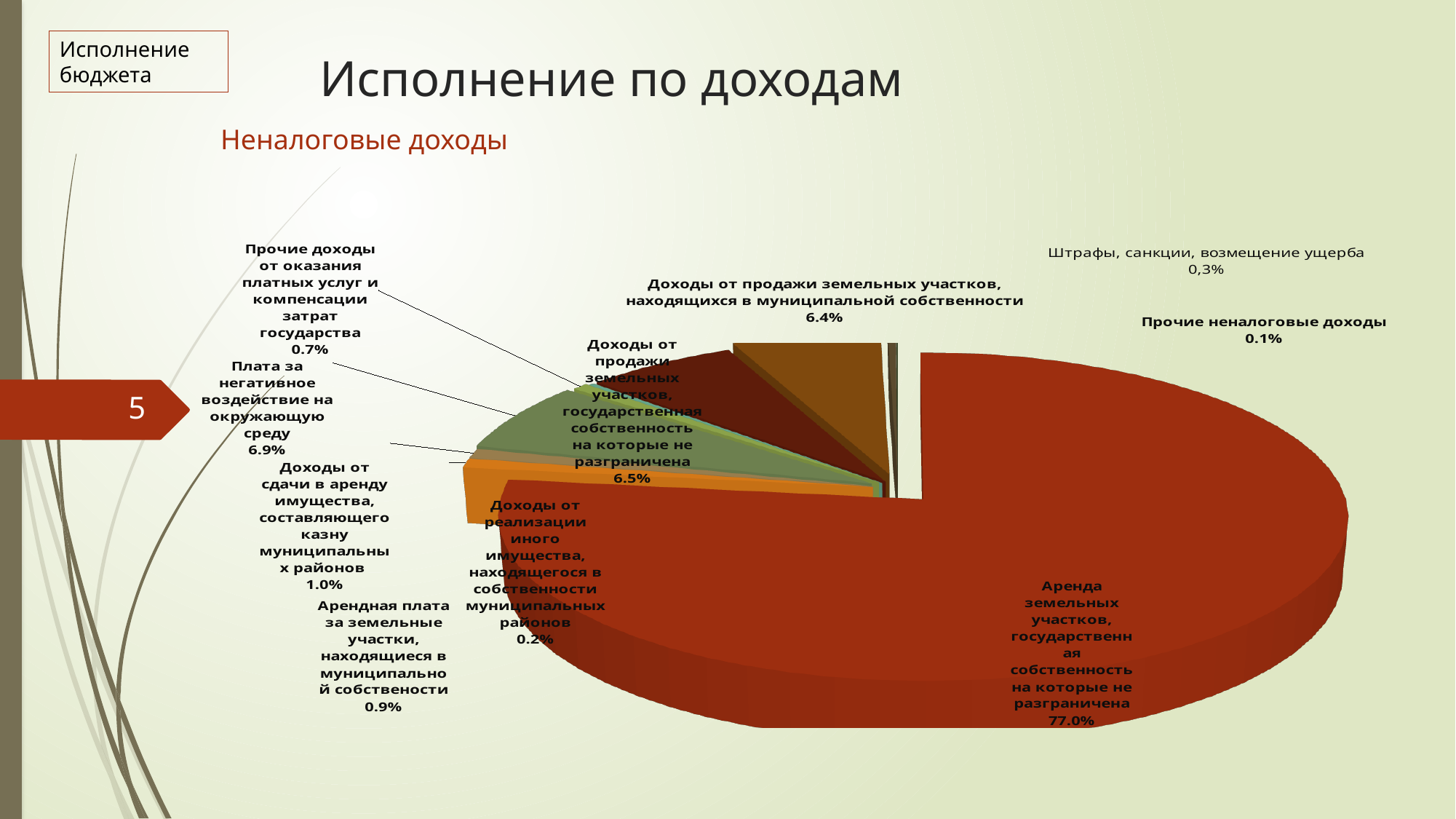
How many categories are shown in the pie chart? 10 Which category has the largest share of the pie? Аренда земельных участков, государственная собственность на которые не разграничена What is the value shown for "Плата за негативное воздействие на окружающую среду"? 6.9% Which category has the smallest share of the pie? Прочие неналоговые доходы Which is larger: the share for "Доходы от сдачи в аренду имущества, составляющего казну муниципальных районов" or for "Арендная плата за земельные участки, находящиеся в муниципальной собственности"? Доходы от сдачи в аренду имущества, составляющего казну муниципальных районов What share of non-tax revenues does "Аренда земельных участков, государственная собственность на которые не разграничена" account for? 77.0% What is the difference between the shares of "Плата за негативное воздействие на окружающую среду" and "Доходы от продажи земельных участков, государственная собственность на которые не разграничена"? 0.4% What is the subtitle of the chart shown on the slide? Неналоговые доходы What is the value shown for "Доходы от реализации иного имущества, находящегося в собственности муниципальных районов"? 0.2% What kind of chart is shown on the slide? Pie chart What is the value shown for "Доходы от продажи земельных участков, находящихся в муниципальной собственности"? 6.4% What is the value shown for "Штрафы, санкции, возмещение ущерба"? 0,3%